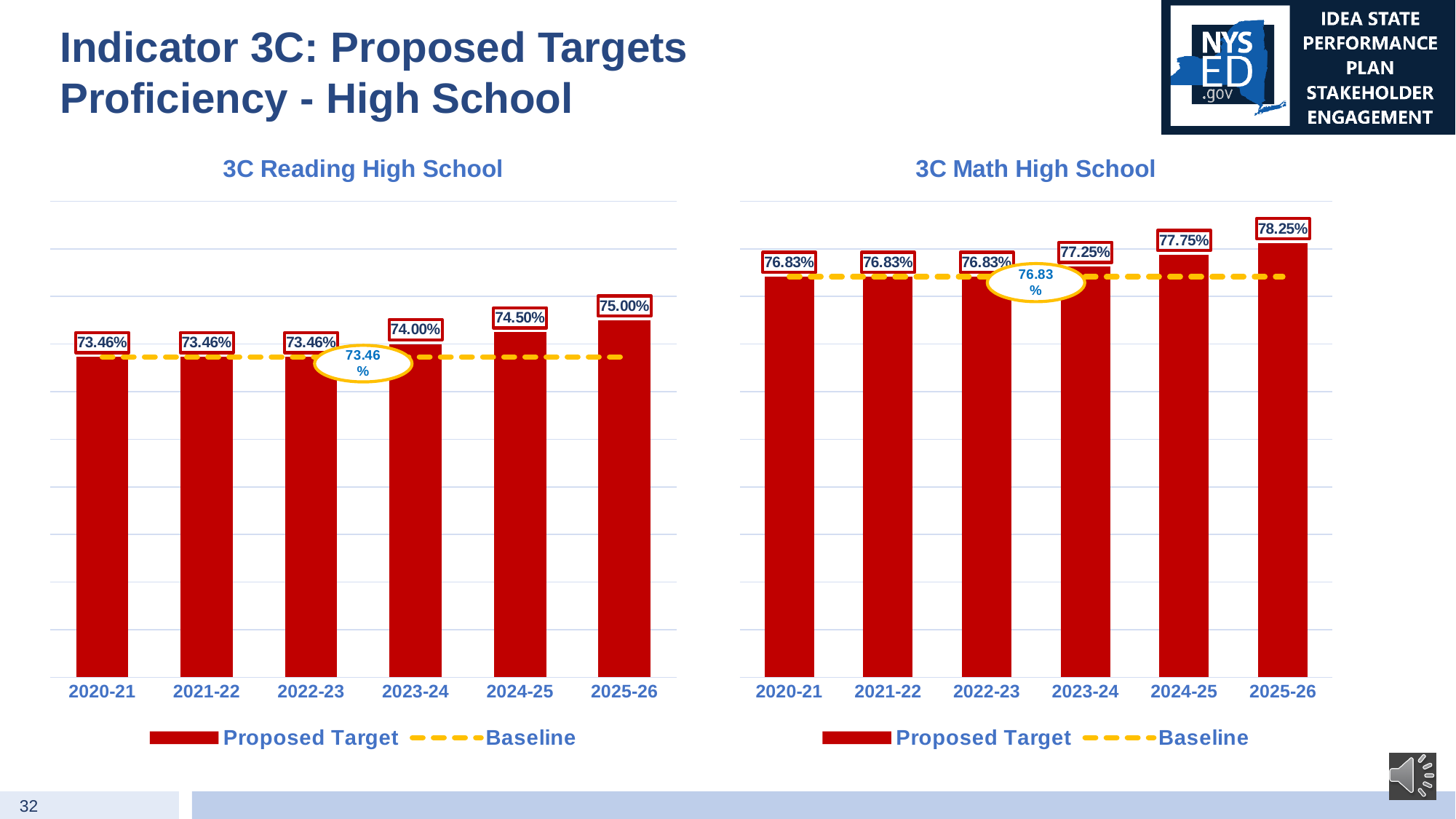
In the 3C Math High School chart, what is the difference between the proposed targets for 2024-25 and 2023-24? 0.50% In the 3C Math High School chart, which year has the highest proposed target? 2025-26 In the 3C Reading High School chart, what is the difference between the proposed targets for 2025-26 and 2020-21? 1.54% In the 3C Math High School chart, which is larger: the proposed target for 2023-24 or for 2021-22? 2023-24 What kind of chart is the 3C Reading High School chart? Bar chart In the 3C Reading High School chart, what is the proposed target for 2023-24? 74.00% In the 3C Math High School chart, what is the proposed target for 2025-26? 78.25% In the 3C Math High School chart, do the proposed targets rise or fall from 2022-23 to 2025-26? Rise How many years are shown on the x axis of the 3C Reading High School chart? 6 How many entries does the legend of the 3C Math High School chart list? 2 In the 3C Reading High School chart, what is the baseline value shown on the dashed line? 73.46% In the 3C Reading High School chart, what does the dashed yellow line represent according to the legend? Baseline